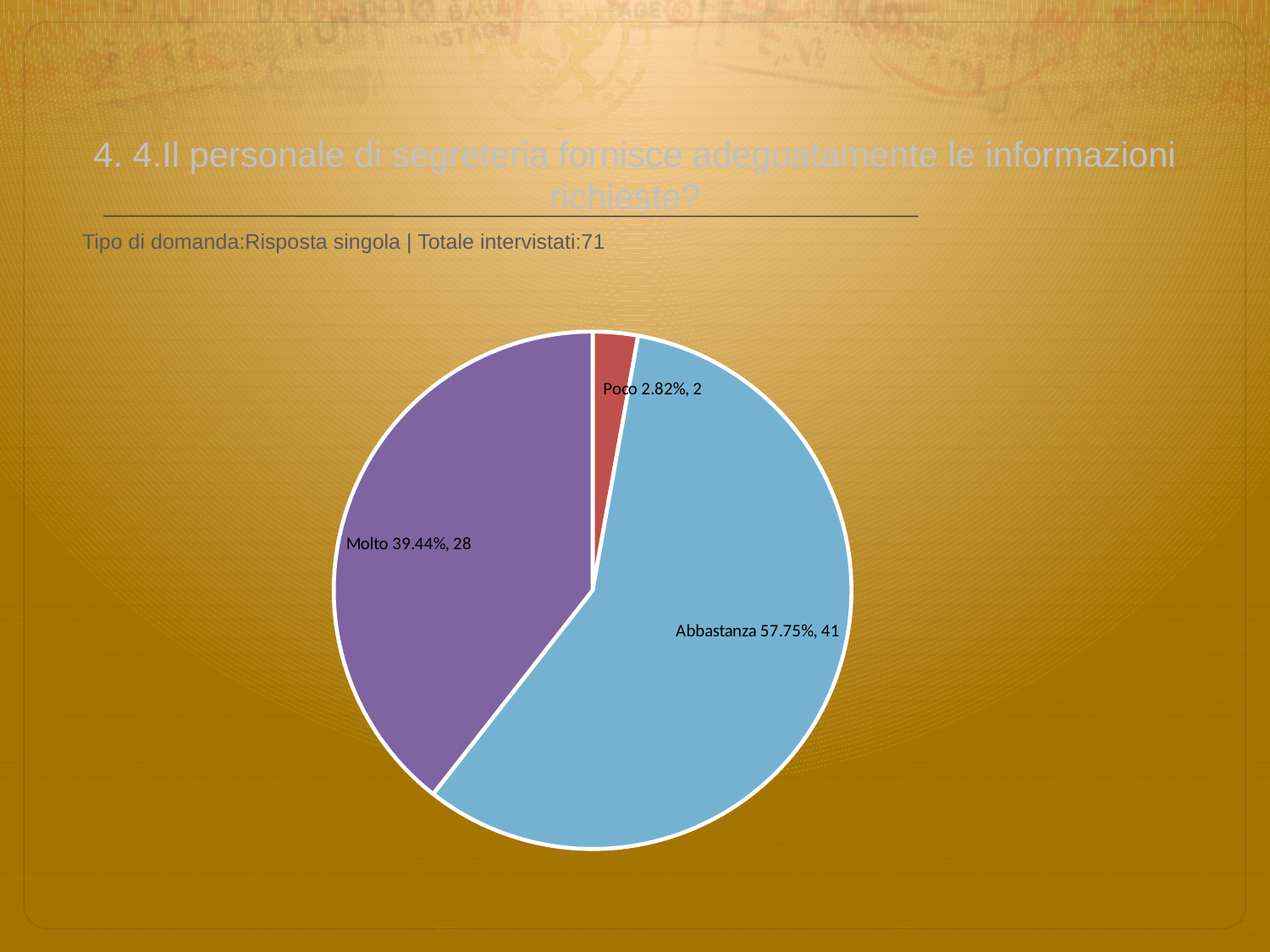
What is the difference in respondent count between Abbastanza and Molto? 13 Which category has the smallest slice? Poco What percentage share does the Abbastanza slice have? 57.75% How many respondents answered Poco? 2 How many respondents answered Abbastanza? 41 Which category has the largest slice? Abbastanza What percentage share does the Poco slice have? 2.82% What kind of chart is shown on the slide? pie chart What percentage share does the Molto slice have? 39.44% Which slice is larger, Molto or Poco? Molto How many respondents answered Molto? 28 How many slices does the pie chart have? 3